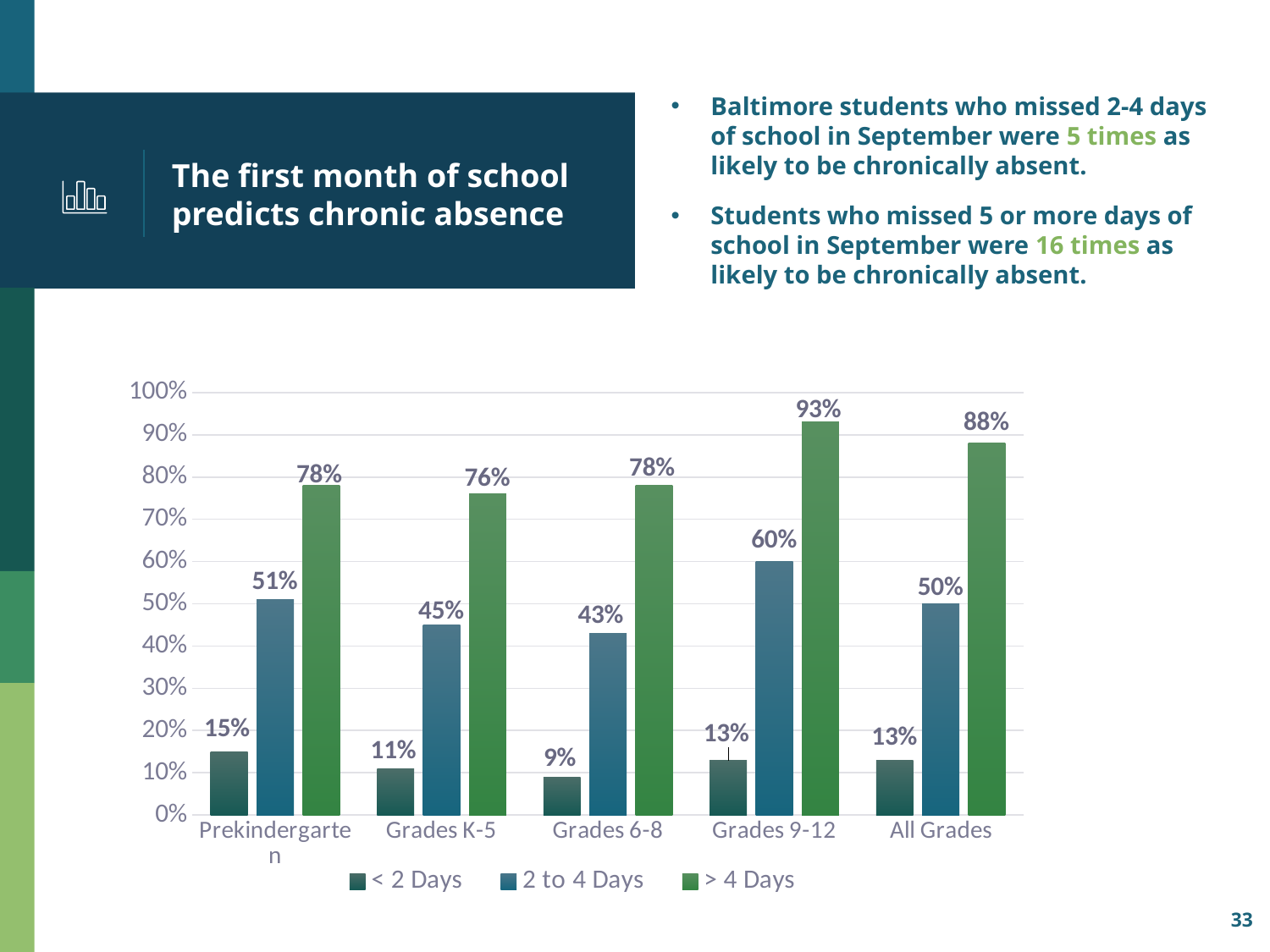
Which is larger: the 2 to 4 Days value for Grades K-5 or for Grades 6-8? Grades K-5 What kind of chart is shown on the slide? Bar chart What is the value for Prekindergarten in the 2 to 4 Days series? 51% What is the value for Grades 9-12 in the > 4 Days series? 93% What is the difference between the > 4 Days and 2 to 4 Days values for All Grades? 38% How many series does the legend list? 3 What are the three series listed in the legend? < 2 Days, 2 to 4 Days, > 4 Days Which category has the lowest value in the < 2 Days series? Grades 6-8 How many categories are shown on the x axis? 5 What is the value for Grades 6-8 in the < 2 Days series? 9% Which category has the highest value in the > 4 Days series? Grades 9-12 What is the value for Grades K-5 in the > 4 Days series? 76%